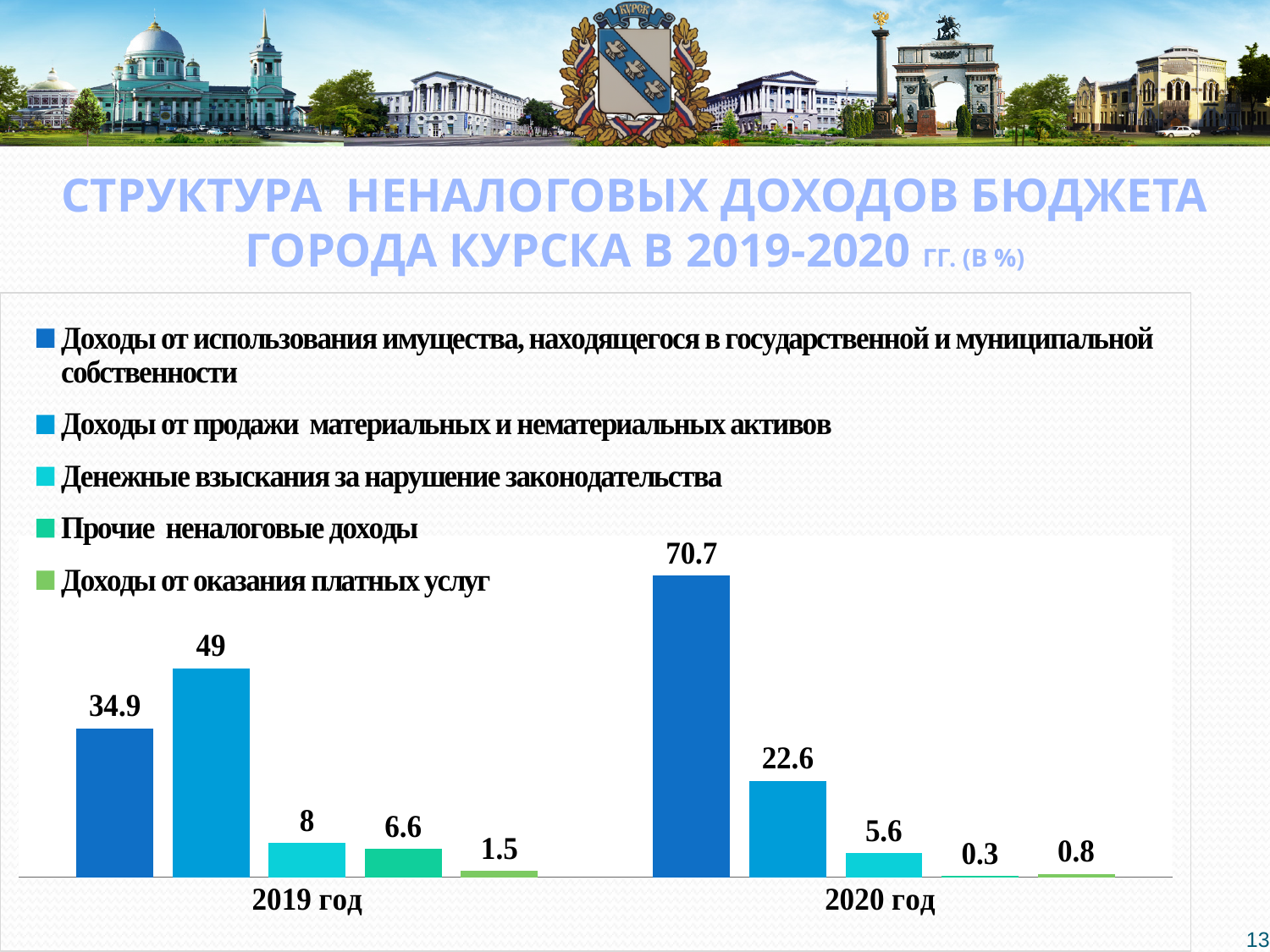
What is the value for «Доходы от использования имущества, находящегося в государственной и муниципальной собственности» in 2019 год? 34.9 What is the difference between the 2020 год and 2019 год values for «Доходы от использования имущества, находящегося в государственной и муниципальной собственности»? 35.8 Which series has the highest value in 2020 год? Доходы от использования имущества, находящегося в государственной и муниципальной собственности What is the value for «Доходы от оказания платных услуг» in 2020 год? 0.8 Does the value for «Прочие неналоговые доходы» rise or fall from 2019 год to 2020 год? Fall How many series does the legend list? 5 Which series has the lowest value in 2019 год? Доходы от оказания платных услуг What kind of chart is shown on the slide? Bar chart What is the value for «Денежные взыскания за нарушение законодательства» in 2019 год? 8 What is the value for «Доходы от продажи материальных и нематериальных активов» in 2020 год? 22.6 How many year categories are shown on the x axis? 2 Which is larger in 2019 год: «Доходы от использования имущества, находящегося в государственной и муниципальной собственности» or «Доходы от продажи материальных и нематериальных активов»? Доходы от продажи материальных и нематериальных активов